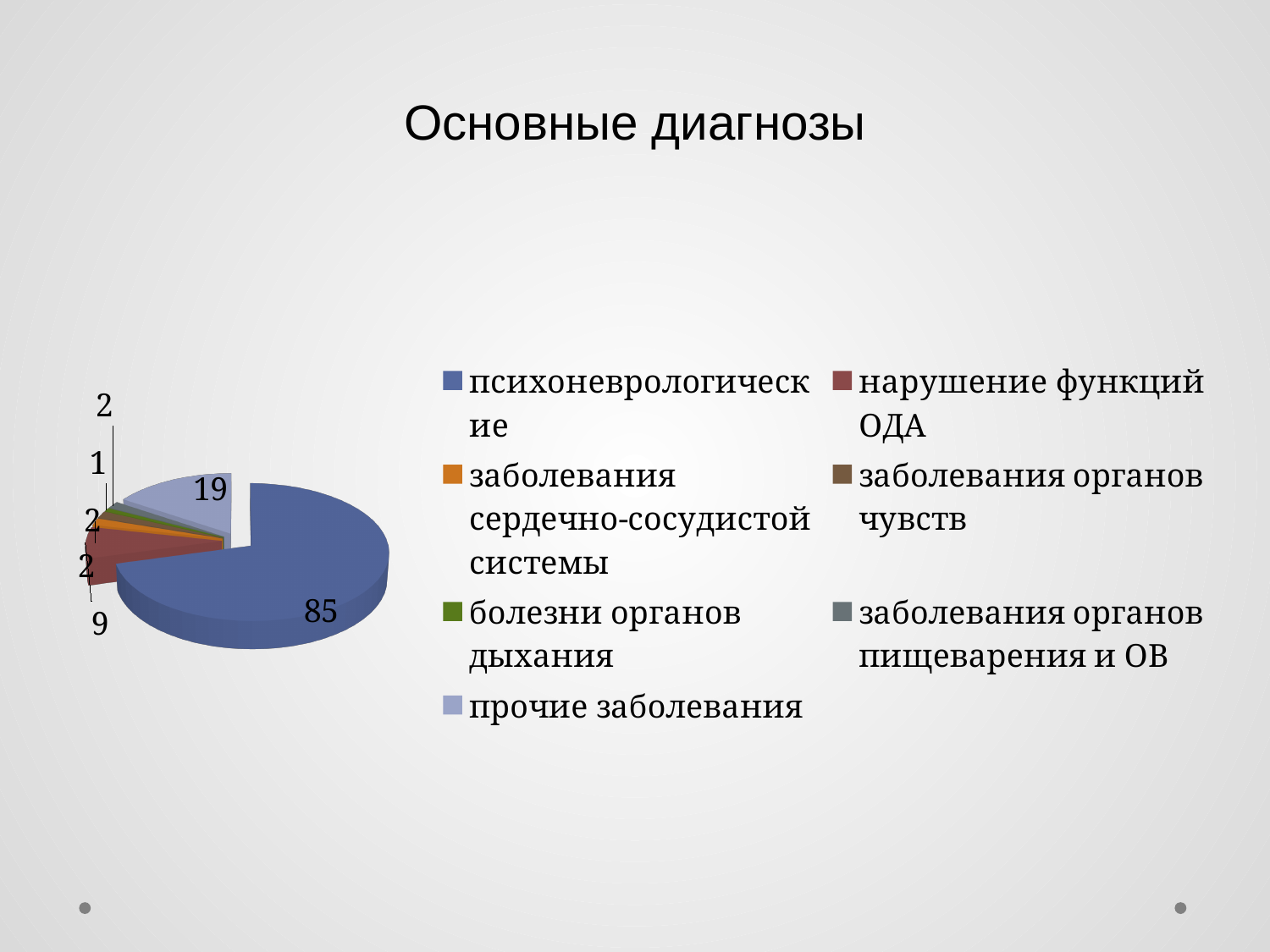
Which category has the smallest slice of the pie? болезни органов дыхания What value is shown for нарушение функций ОДА? 9 What value is shown for заболевания органов чувств? 2 What value is shown for психоневрологические? 85 What kind of chart is shown on the slide? pie chart What is the sum of all the values shown on the pie chart? 120 What value is shown for прочие заболевания? 19 Which is larger: прочие заболевания or нарушение функций ОДА? прочие заболевания What is the title of the chart? Основные диагнозы What is the difference between the values for психоневрологические and прочие заболевания? 66 How many categories does the legend list? 7 Which category has the largest slice of the pie? психоневрологические